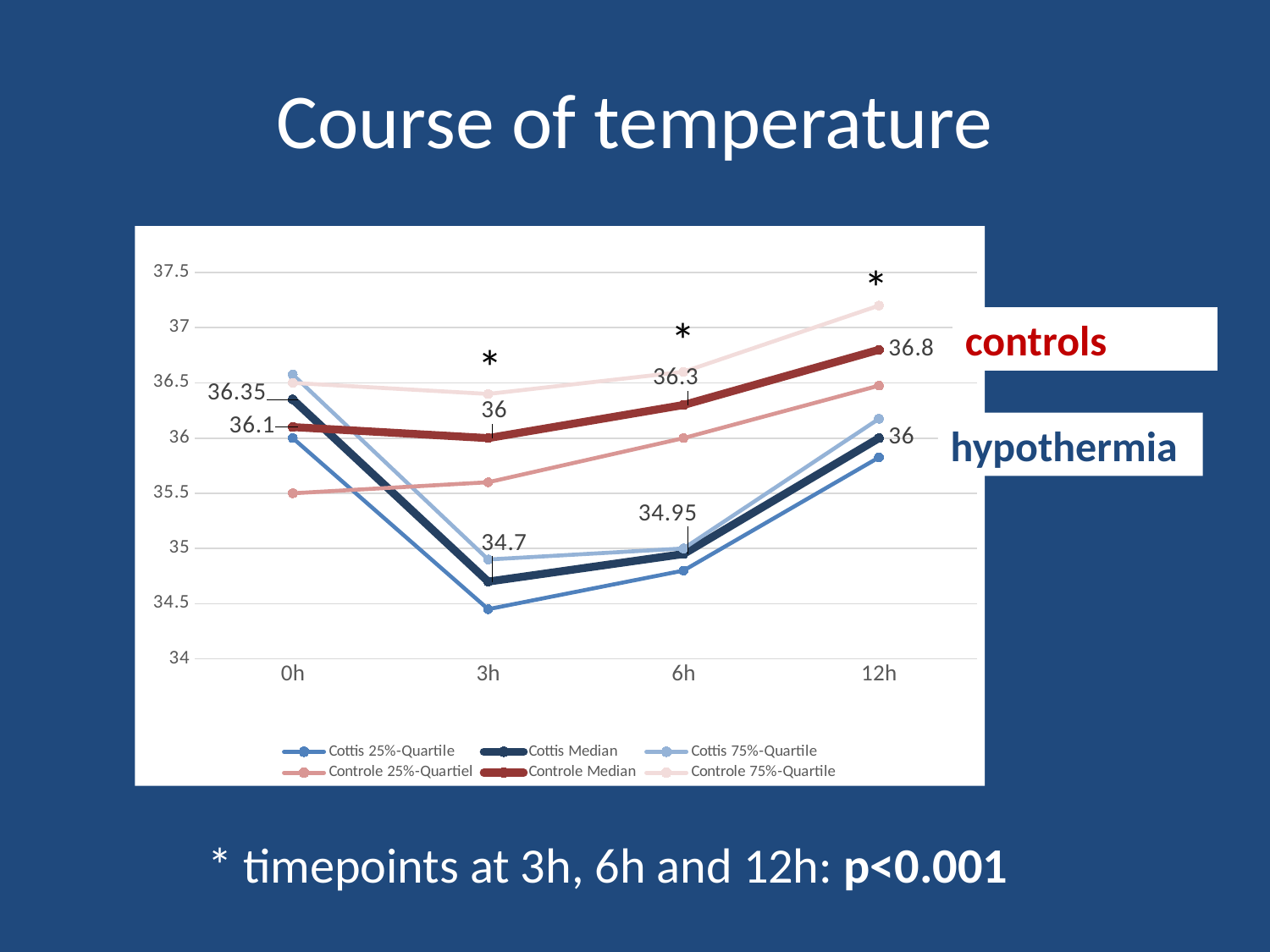
What is the Cottis Median value at 3h? 34.7 What kind of chart is shown on the slide? line chart How many timepoints are shown on the x axis? 4 At which timepoint is the Cottis Median lowest? 3h What is the Cottis Median value at 0h? 36.35 At which timepoint is the Controle Median highest? 12h What is the difference between the Controle Median and the Cottis Median at 3h? 1.3 Which is larger at 0h, the Cottis Median or the Controle Median? Cottis Median What is the Controle Median value at 6h? 36.3 How many series does the legend list? 6 What is the Controle Median value at 12h? 36.8